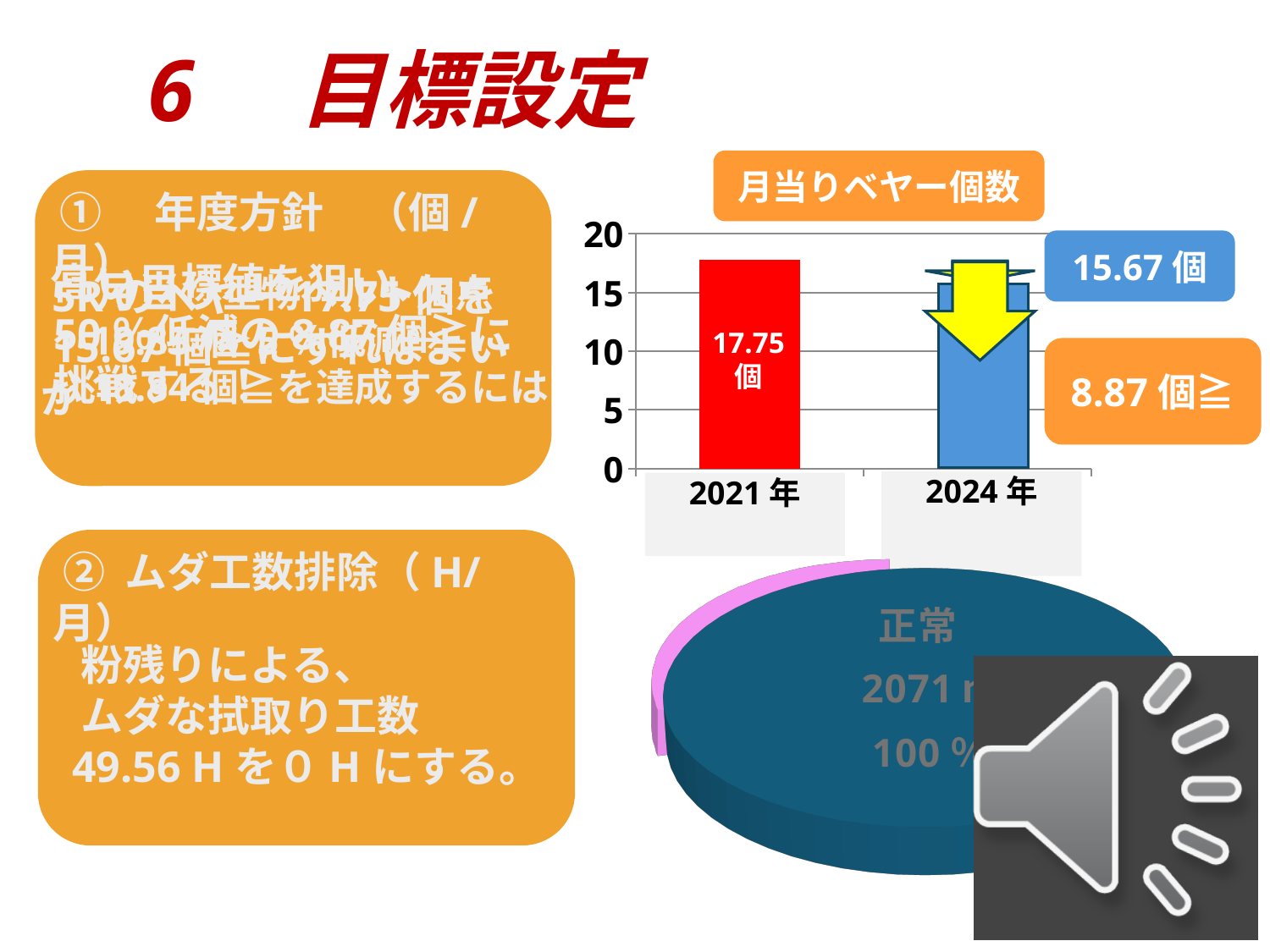
In the bar chart titled 月当りベヤー個数, do the values rise or fall from 2021年 to 2024年? fall In the bar chart titled 月当りベヤー個数, what is the value for 2021年? 17.75個 In the bar chart titled 月当りベヤー個数, which year has the lower bar? 2024年 In the bar chart titled 月当りベヤー個数, which year has the higher bar? 2021年 What kind of chart is the lower chart on the slide? pie chart What is the highest tick value on the vertical axis of the bar chart titled 月当りベヤー個数? 20 How many bars are shown in the bar chart titled 月当りベヤー個数? 2 In the bar chart titled 月当りベヤー個数, is the value for 2024年 greater or less than 20? less What kind of chart is the upper chart titled 月当りベヤー個数? bar chart In the bar chart titled 月当りベヤー個数, is the value for 2024年 greater or less than 10? greater In the bar chart titled 月当りベヤー個数, what colour is the bar for 2021年? red In the bar chart titled 月当りベヤー個数, is the value for 2021年 greater or less than 15? greater